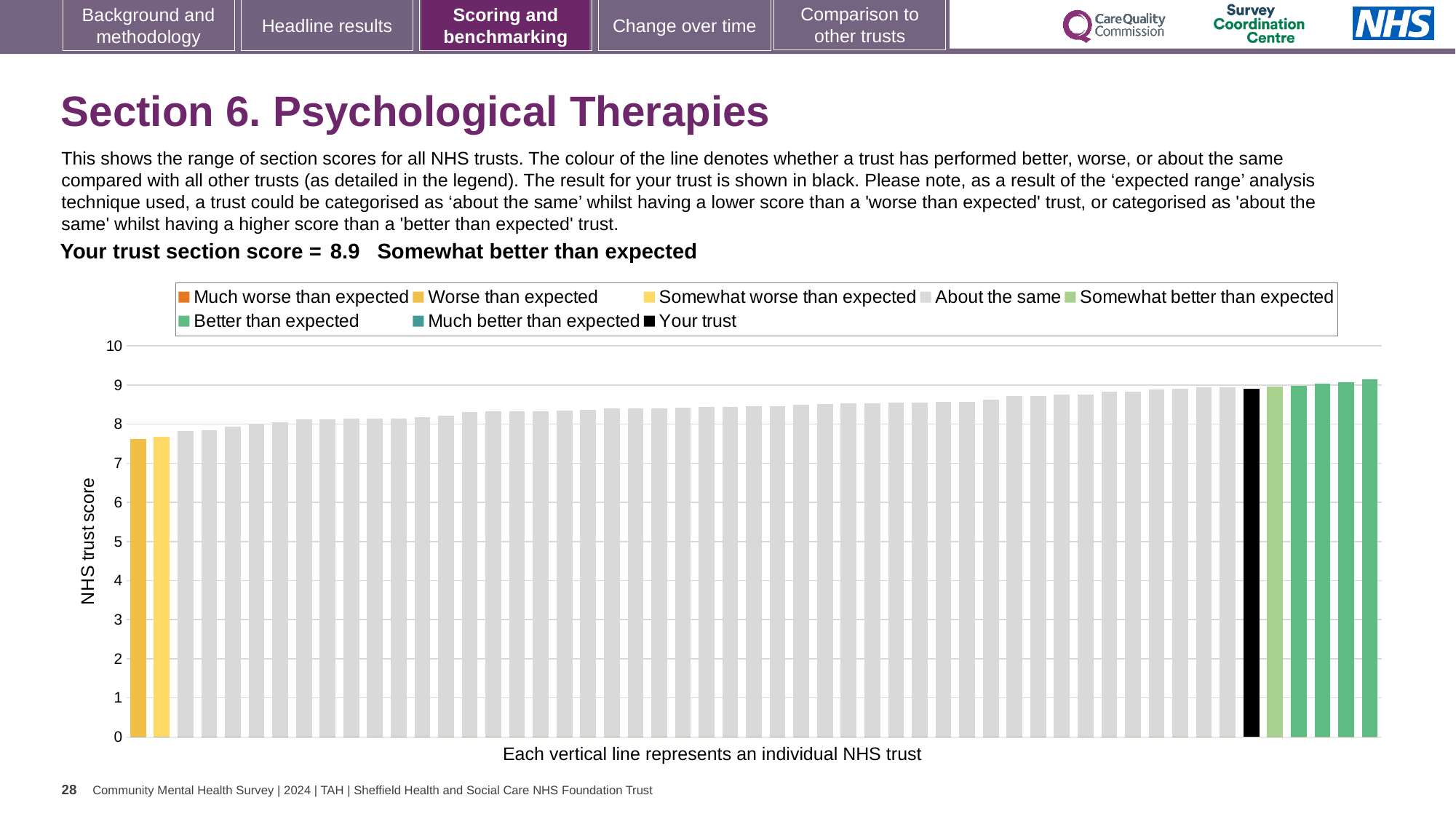
Do the bar values rise or fall from left to right along the x axis? rise How many entries does the chart legend list? 8 What is the label on the vertical axis of the chart? NHS trust score Which bar is taller: the black 'Your trust' bar or the leftmost bar? the black 'Your trust' bar Is the value of the black 'Your trust' bar greater or less than 8? greater Is the value of the rightmost (tallest) bar greater or less than 9? greater What is the section score for your trust shown on the slide? 8.9 Is the value of the leftmost bar greater or less than 8? less What is the highest value shown on the vertical axis? 10 What type of chart is shown on the slide? bar chart What colour is the bar representing your trust? black